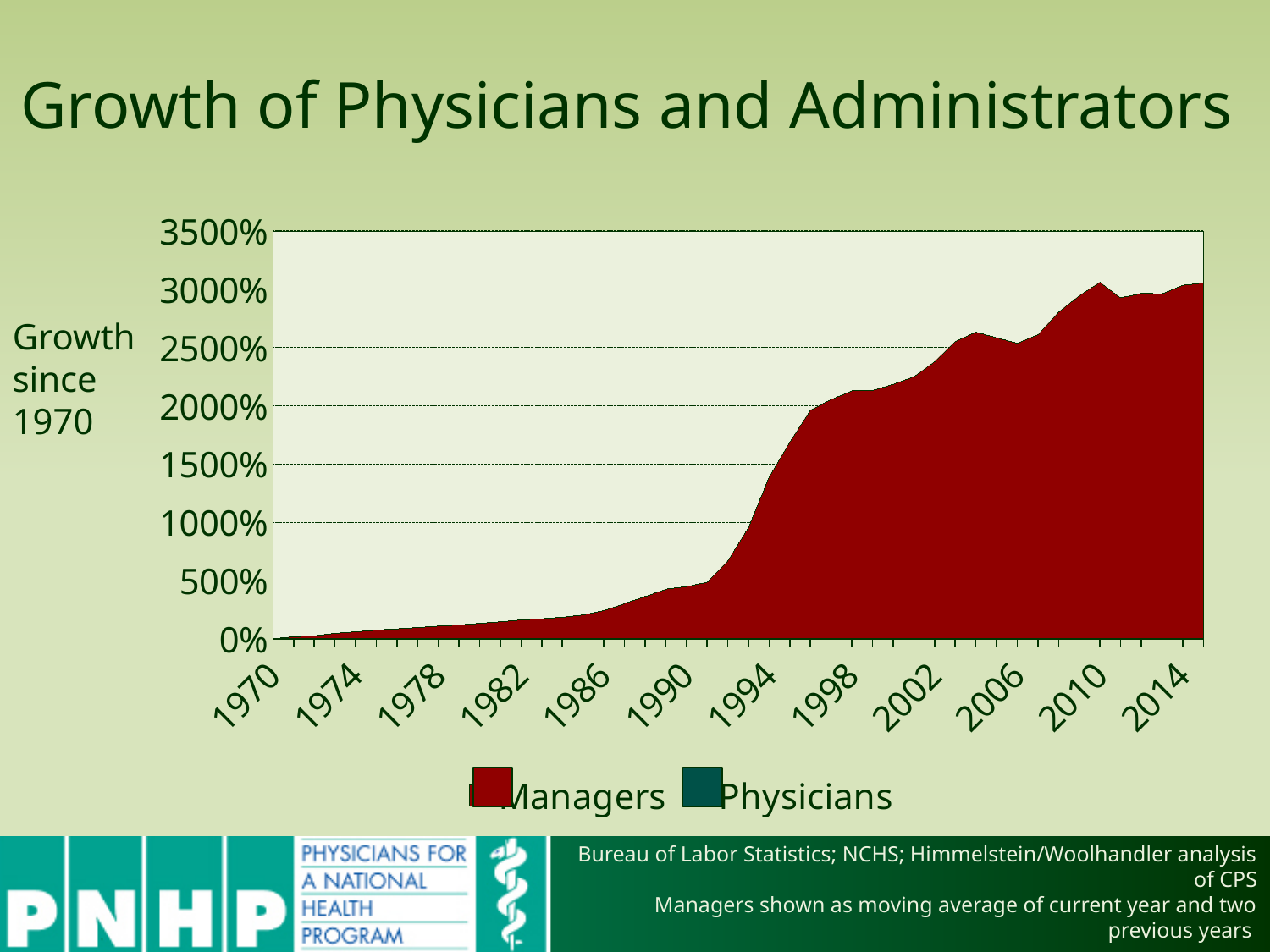
Is the value for Managers in 2002 greater or less than 2500%? less Is the value for Managers in 2014 greater or less than 2500%? greater What kind of chart is shown on the slide? area chart How many series does the legend list? 2 Is the value for Managers in 2006 greater or less than 3000%? less Does the Managers series generally rise or fall from 1970 to 2014? rise What are the two series named in the legend? Managers and Physicians In 2014, which series has the larger value, Managers or Physicians? Managers How many year labels are shown on the x axis? 12 What is the title of the chart? Growth of Physicians and Administrators